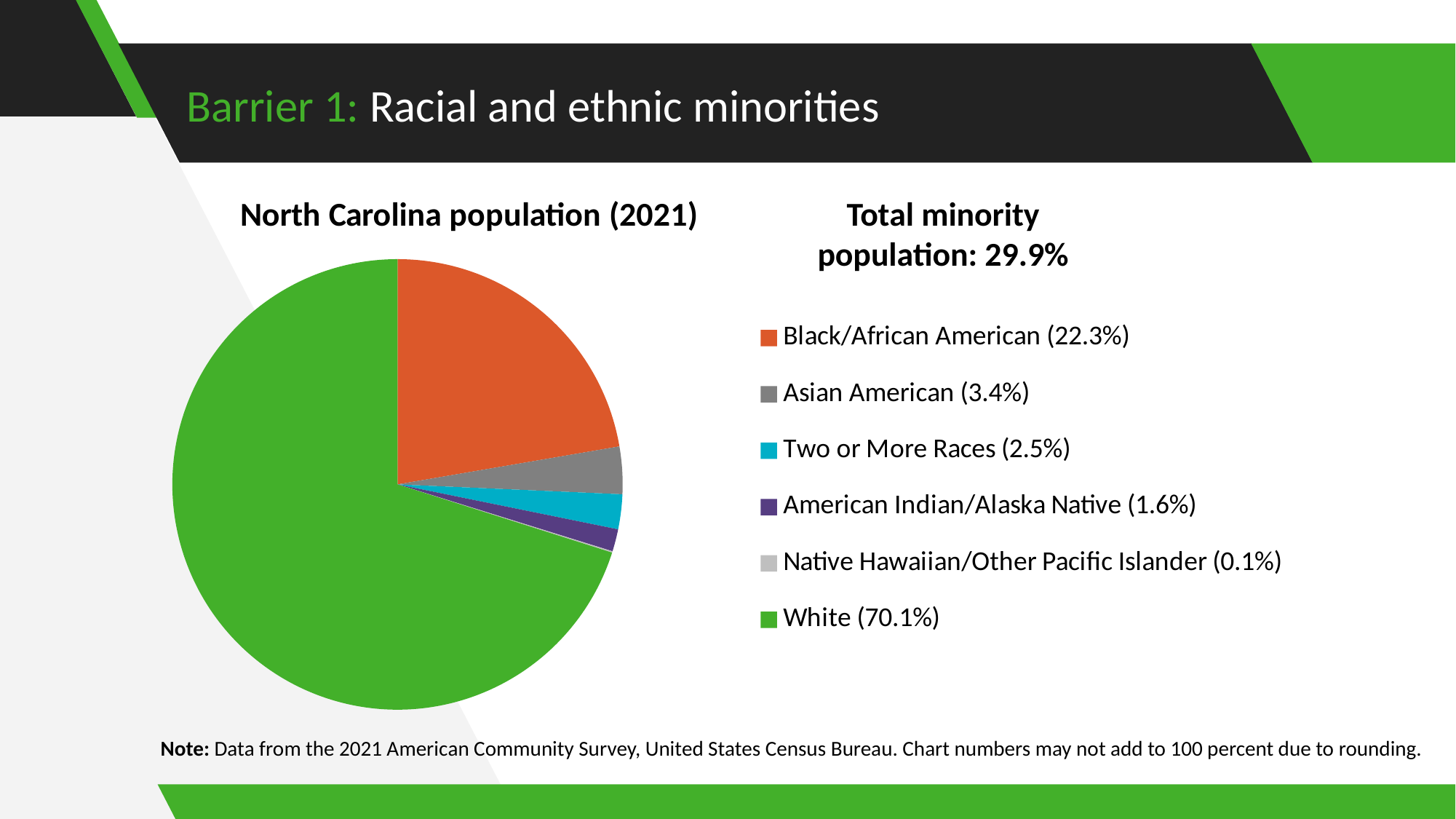
What is the title of the chart? North Carolina population (2021) Which category has the largest share of the pie? White What share of the North Carolina population is Black/African American? 22.3% What colour is the slice for Two or More Races? Blue Which category has the smallest share of the pie? Native Hawaiian/Other Pacific Islander How many categories does the pie chart show? 6 What share of the North Carolina population is American Indian/Alaska Native? 1.6% Which is larger, the share for Two or More Races or the share for Asian American? Asian American What kind of chart is shown on the slide? Pie chart What share of the North Carolina population is Asian American? 3.4% What is the difference in percentage points between the White share and the Black/African American share? 47.8 What share of the North Carolina population is White? 70.1%